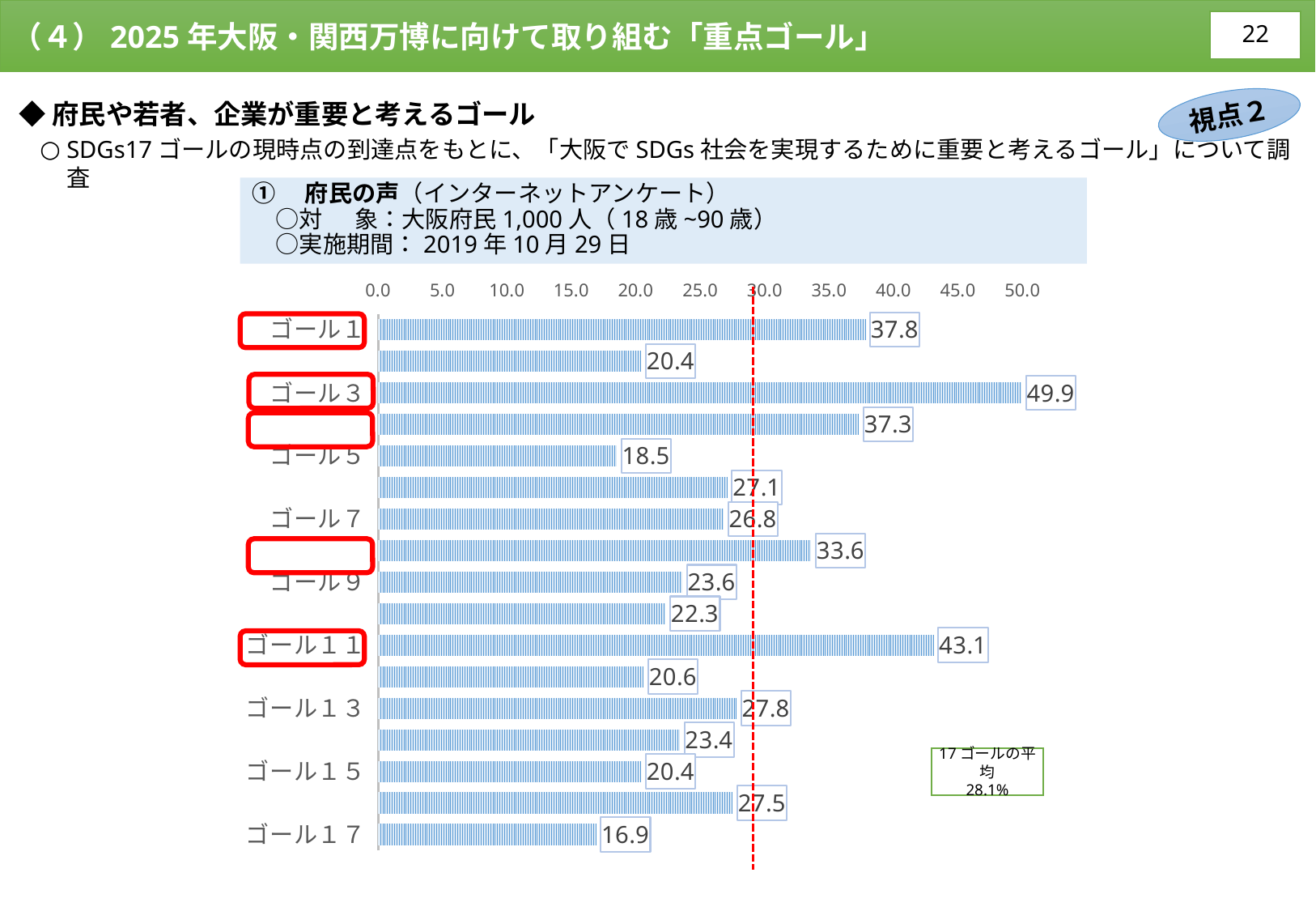
Which has a larger value, ゴール1 or ゴール13? ゴール1 What is the difference between the values for ゴール3 and ゴール11? 6.8 What average value for the 17 goals is shown in the box on the chart? 28.1% What is the value for ゴール11 in the bar chart? 43.1 How many bars are plotted in the chart? 17 What kind of chart is shown on the slide? bar chart What is the value for ゴール1 in the bar chart? 37.8 Which goal has the highest value in the bar chart? ゴール3 Which goal has the lowest value in the bar chart? ゴール17 What is the value for ゴール17 in the bar chart? 16.9 Is the value for ゴール5 greater or less than 20.0? less What is the value for ゴール3 in the bar chart? 49.9